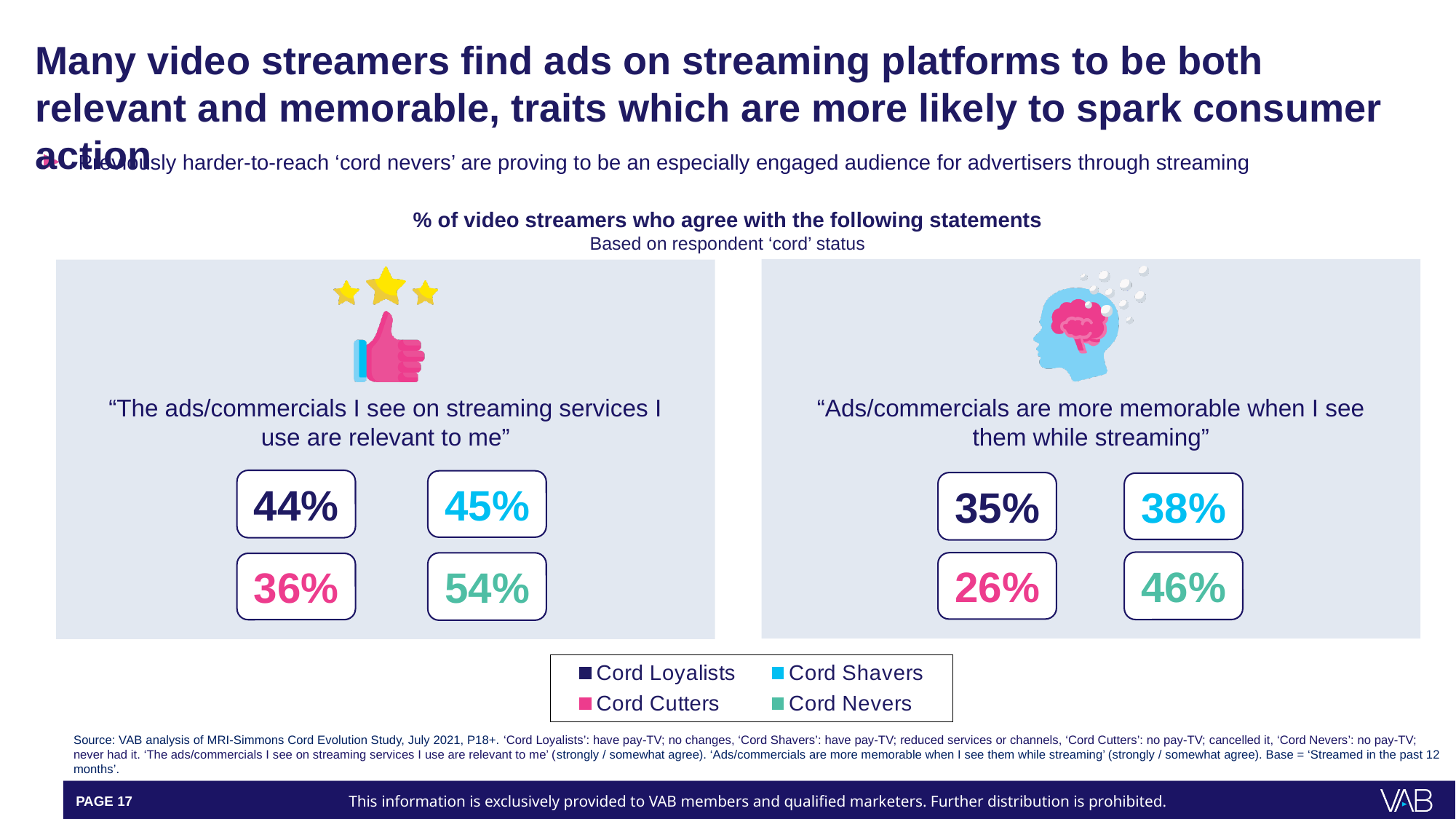
In the chart for "Ads/commercials are more memorable when I see them while streaming", what is the difference between the Cord Nevers and Cord Loyalists values? 11 percentage points In the chart for "Ads/commercials are more memorable when I see them while streaming", which is larger: the Cord Shavers value or the Cord Cutters value? Cord Shavers In the chart for "Ads/commercials are more memorable when I see them while streaming", which cord status group has the lowest share agreeing? Cord Cutters In the chart for "The ads/commercials I see on streaming services I use are relevant to me", what is the difference between the Cord Nevers and Cord Cutters values? 18 percentage points Is the Cord Nevers value for the "relevant to me" statement larger or smaller than the Cord Nevers value for the "more memorable" statement? larger In the chart for "The ads/commercials I see on streaming services I use are relevant to me", what percentage of Cord Nevers agree? 54% In the chart for "The ads/commercials I see on streaming services I use are relevant to me", which cord status group has the highest share agreeing? Cord Nevers In the chart for "The ads/commercials I see on streaming services I use are relevant to me", what percentage of Cord Cutters agree? 36% Which cord status group is shown in pink in the legend? Cord Cutters How many cord status groups does the legend list? 4 In the chart for "Ads/commercials are more memorable when I see them while streaming", what percentage of Cord Shavers agree? 38% In the chart for "Ads/commercials are more memorable when I see them while streaming", what percentage of Cord Loyalists agree? 35%